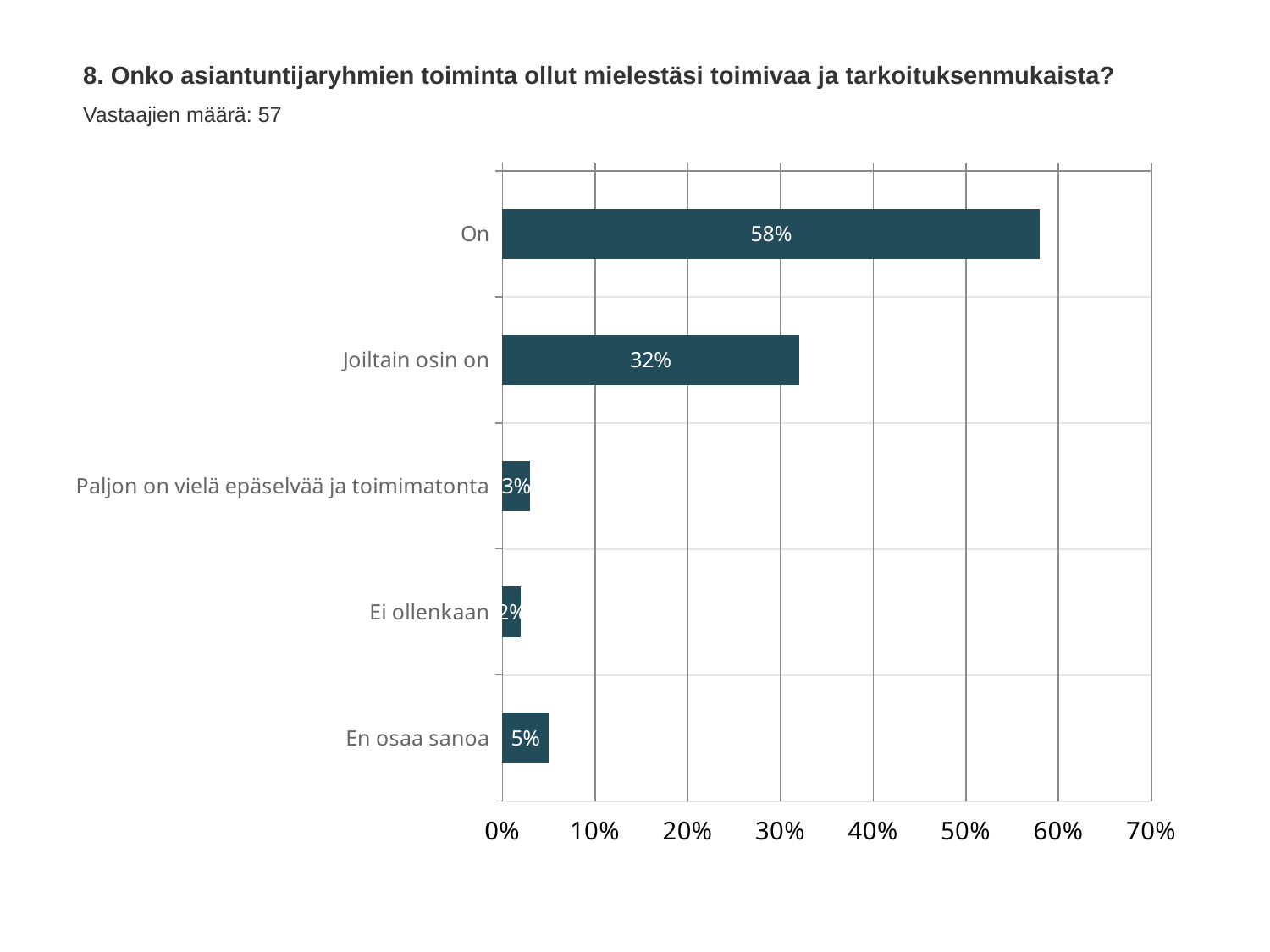
Which category has the lowest value? Ei ollenkaan What is the value for "Joiltain osin on"? 32% What is the value for "En osaa sanoa"? 5% Which category has the highest value? On What is the difference between the values for "On" and "Joiltain osin on"? 26% What is the value for "Ei ollenkaan"? 2% What kind of chart is shown on the slide? bar chart What is the value for "On"? 58% Which is larger, the value for "En osaa sanoa" or the value for "Paljon on vielä epäselvää ja toimimatonta"? En osaa sanoa How many categories are shown in the chart? 5 What is the value for "Paljon on vielä epäselvää ja toimimatonta"? 3% How many respondents (Vastaajien määrä) are stated on the slide? 57